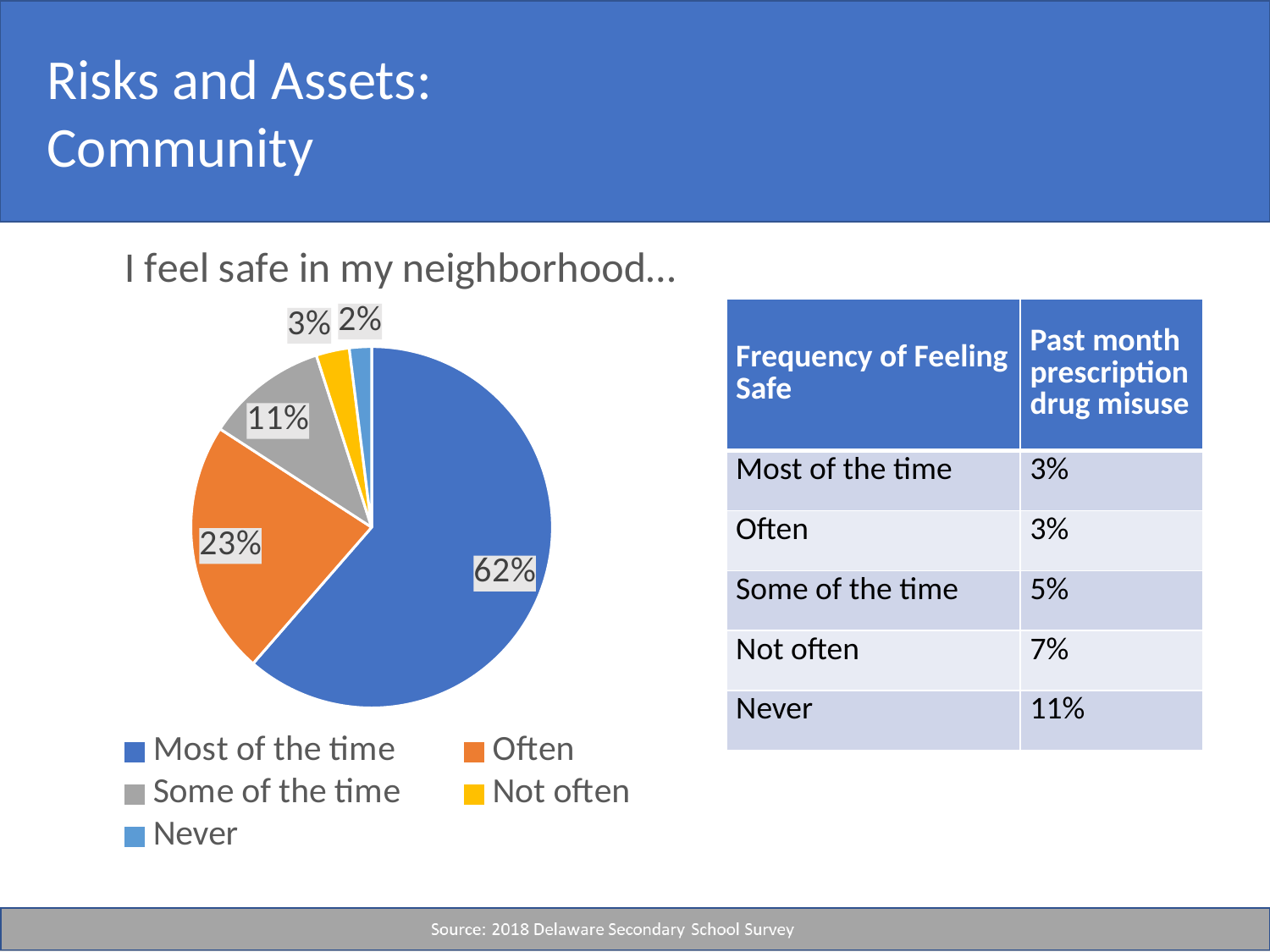
What colour is the "Often" slice in the pie chart? Orange Which slice is larger in the pie chart, "Often" or "Some of the time"? Often What percentage does the "Often" slice show in the pie chart? 23% What is the difference in percentage points between the "Most of the time" and "Often" slices? 39 What percentage is shown for "Never" in the pie chart? 2% How many categories does the pie chart show? 5 What is the value shown for "Some of the time" in the pie chart? 11% What share of the pie chart is labelled "Most of the time"? 62% What type of chart is shown on the slide? Pie chart Which category has the smallest slice in the pie chart? Never What percentage is shown for "Not often" in the pie chart? 3% Which category has the largest slice in the pie chart? Most of the time